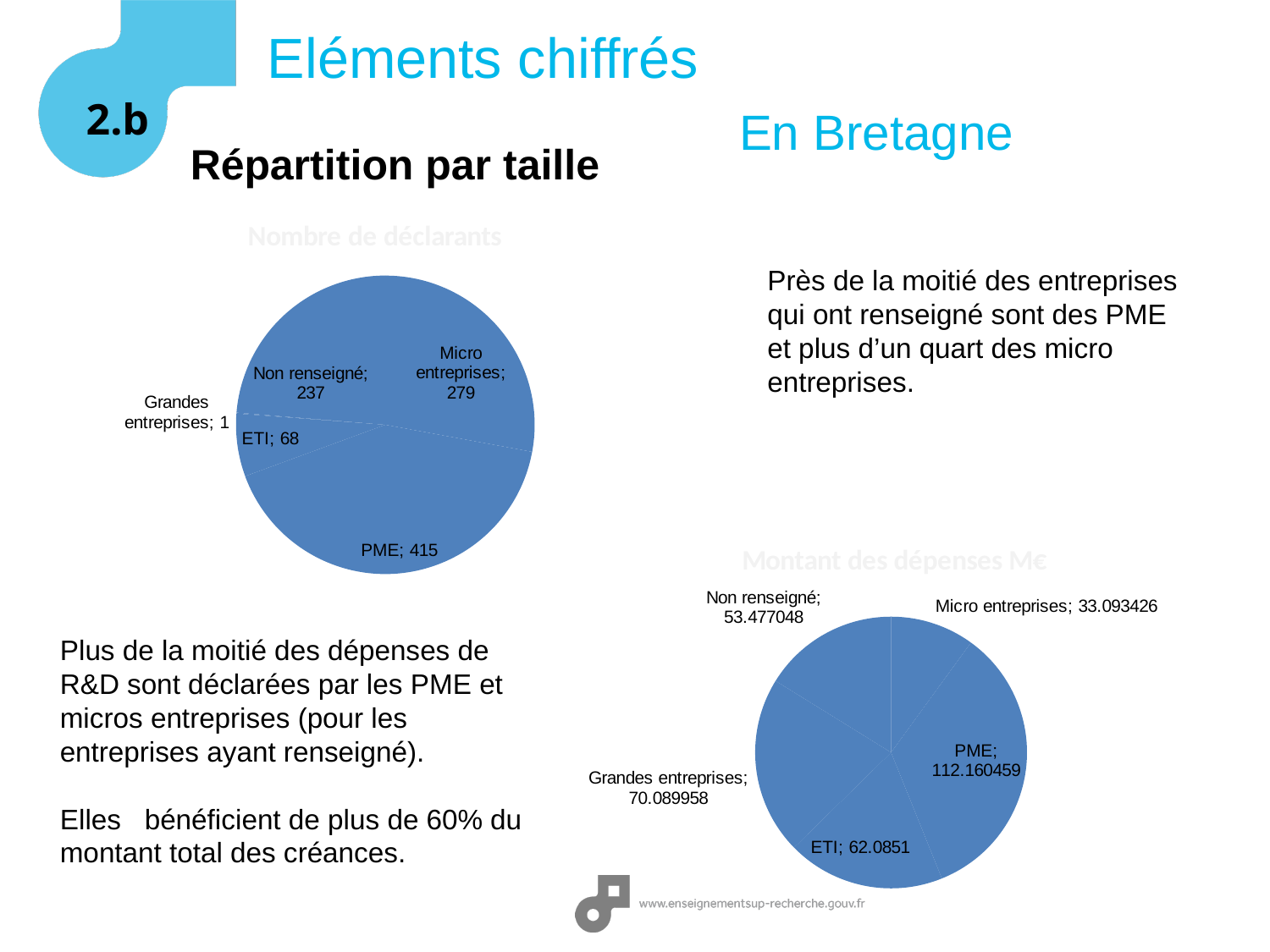
In the lower-right pie chart, what is the value for ETI? 62.0851 In the lower-right pie chart, what is the value for Grandes entreprises? 70.089958 In the upper-left pie chart, which category has the largest value? PME In the lower-right pie chart, which category has the largest value? PME In the upper-left pie chart, what is the value for Non renseigné? 237 How many categories does the upper-left pie chart show? 5 In the upper-left pie chart, what share of the total does PME represent? 41.5% In the upper-left pie chart, what is the value for PME? 415 What kind of chart is the lower-right chart? Pie chart In the upper-left pie chart, which category has the smallest value? Grandes entreprises In the lower-right pie chart, which is larger, Non renseigné or Micro entreprises? Non renseigné In the upper-left pie chart, what is the difference between Micro entreprises and Non renseigné? 42